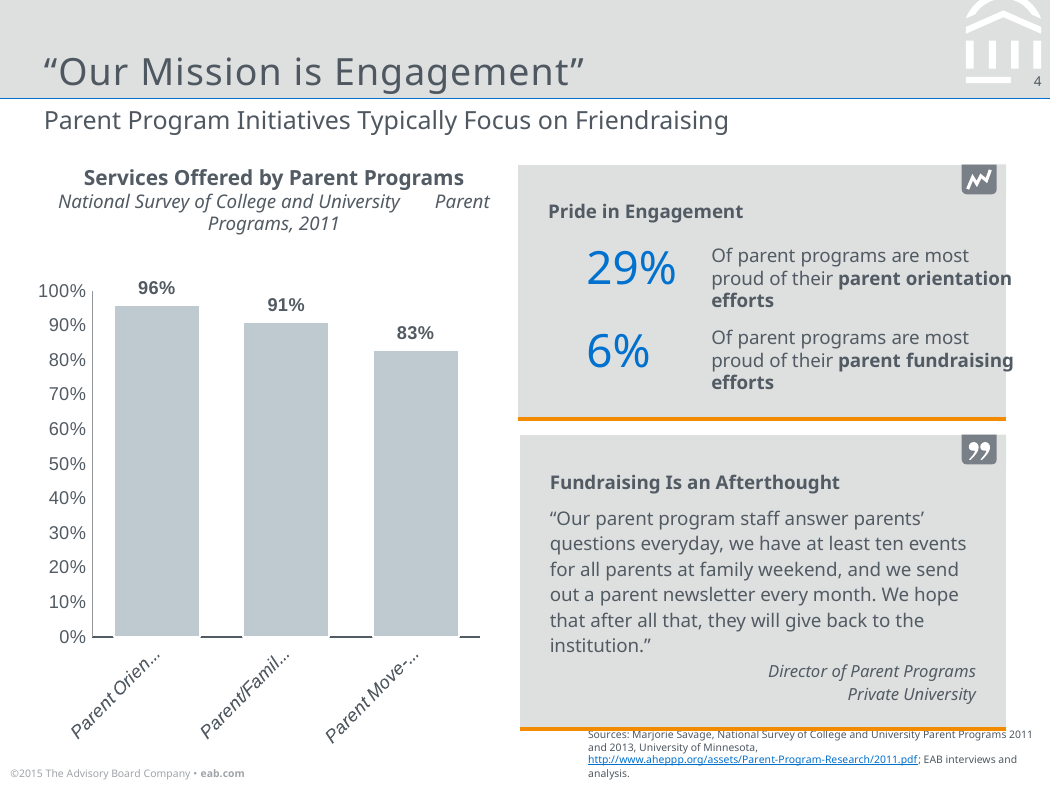
How many bars are plotted in the "Services Offered by Parent Programs" chart? 3 In the "Services Offered by Parent Programs" chart, which is larger: the value for "Parent/Famil..." or the value for "Parent Move-..."? Parent/Famil... Which bar has the lowest value in the "Services Offered by Parent Programs" chart? Parent Move-... (83%) What is the value of the third bar (labelled "Parent Move-...") in the "Services Offered by Parent Programs" chart? 83% What is the value of the first bar (labelled "Parent Orien...") in the "Services Offered by Parent Programs" chart? 96% What type of chart is shown under the title "Services Offered by Parent Programs"? Bar chart What is the value of the second bar (labelled "Parent/Famil...") in the "Services Offered by Parent Programs" chart? 91% Is the value for "Parent Move-..." in the "Services Offered by Parent Programs" chart greater or less than 90%? less Do the bar values rise or fall from left to right in the "Services Offered by Parent Programs" chart? Fall In the "Services Offered by Parent Programs" chart, what is the difference between the first bar (96%) and the third bar (83%)? 13 percentage points Which bar has the highest value in the "Services Offered by Parent Programs" chart? Parent Orien... (96%) What is the subtitle shown beneath the chart title "Services Offered by Parent Programs"? National Survey of College and University Parent Programs, 2011